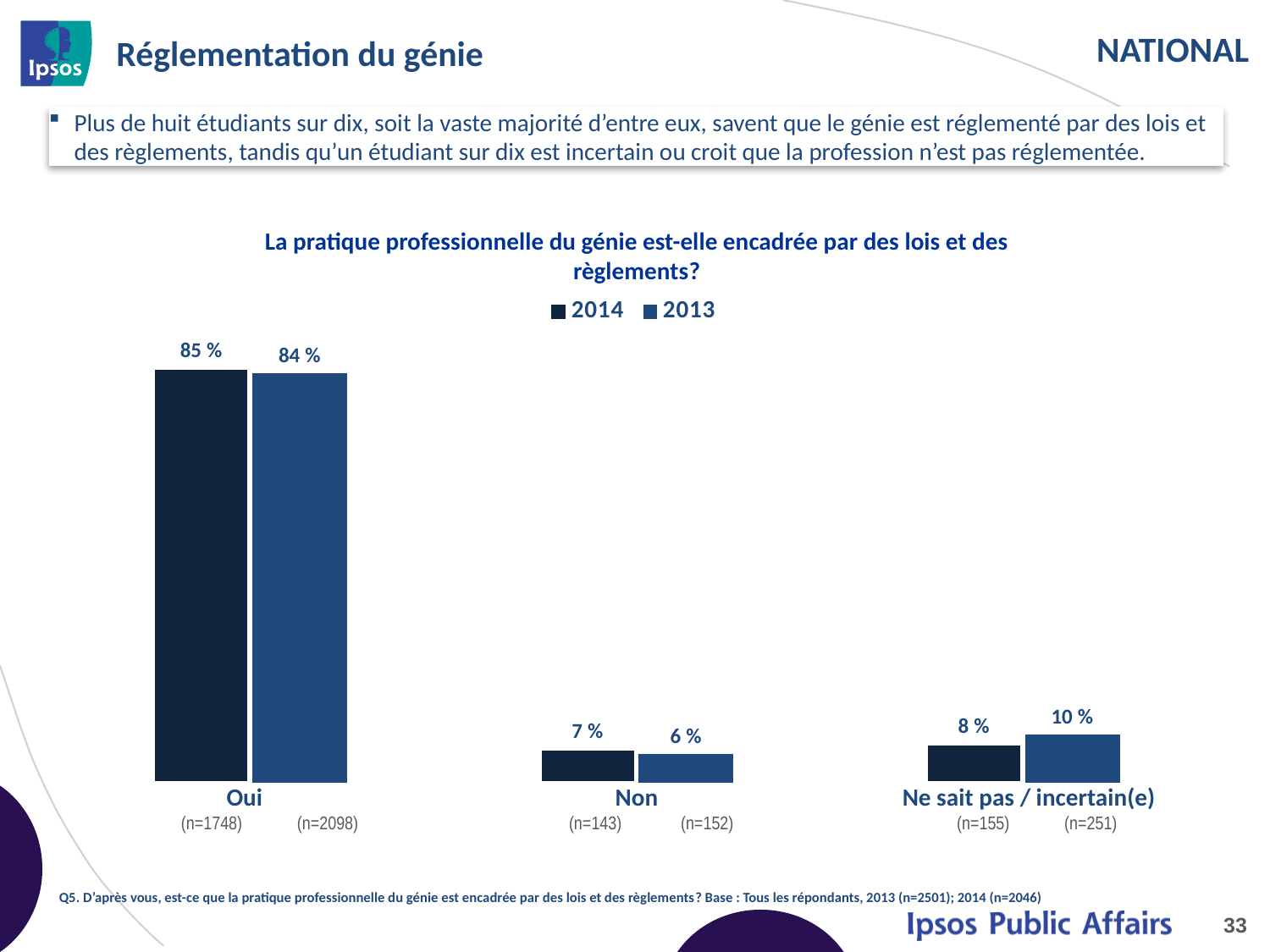
What is the value for "Oui" in the 2014 series? 85 % What is the difference between the 2014 and 2013 values for "Ne sait pas / incertain(e)"? 2 % What is the value for "Ne sait pas / incertain(e)" in the 2013 series? 10 % What is the difference between the 2014 values for "Oui" and "Non"? 78 % For "Non", which series has the larger value, 2014 or 2013? 2014 How many series does the legend list? 2 Which category has the lowest value in the 2013 series? Non What is the value for "Non" in the 2013 series? 6 % How many categories are shown on the x axis? 3 Which series does the legend list first? 2014 What kind of chart is shown on the slide? Bar chart Which category has the highest value in the 2014 series? Oui